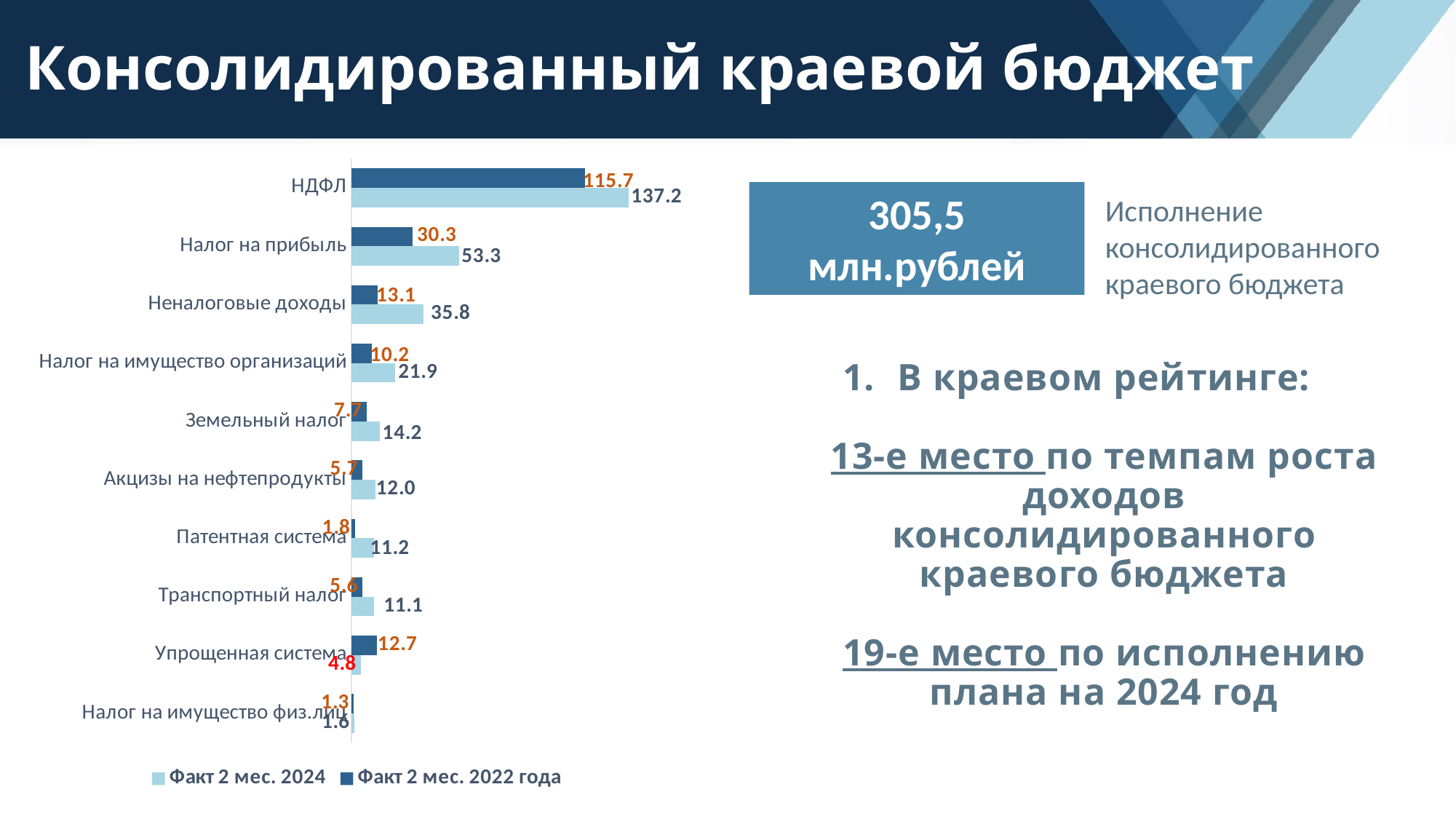
What is the value for НДФЛ in the Факт 2 мес. 2024 series? 137.2 Which category has the lowest value in the Факт 2 мес. 2022 года series? Налог на имущество физ.лиц What is the difference between the Факт 2 мес. 2024 and Факт 2 мес. 2022 года values for НДФЛ? 21.5 What is the value for Патентная система in the Факт 2 мес. 2022 года series? 1.8 For Упрощенная система, which series has the larger value: Факт 2 мес. 2024 or Факт 2 мес. 2022 года? Факт 2 мес. 2022 года What is the value for Налог на прибыль in the Факт 2 мес. 2022 года series? 30.3 What type of chart is shown on the slide? Bar chart Which category has the highest value in the Факт 2 мес. 2024 series? НДФЛ What is the difference between the Факт 2 мес. 2024 and Факт 2 мес. 2022 года values for Неналоговые доходы? 22.7 What is the value for Упрощенная система in the Факт 2 мес. 2024 series? 4.8 How many categories are shown in the chart? 10 How many series does the legend list? 2